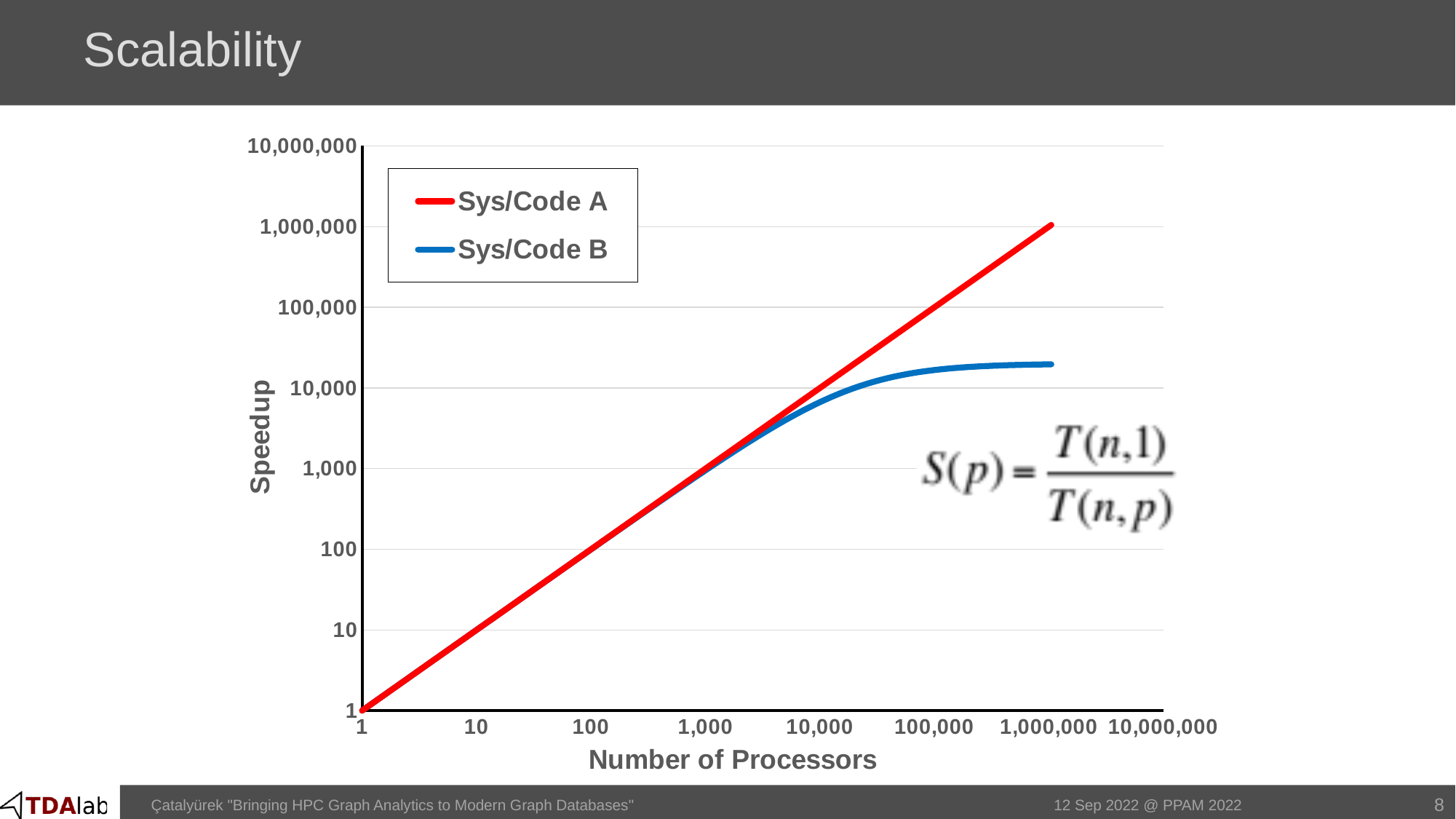
Is the speedup for Sys/Code B at 1,000,000 processors greater or less than 100,000? less Is the speedup for Sys/Code A at 1,000,000 processors greater or less than 100,000? greater Does the speedup for Sys/Code A rise or fall as the number of processors increases? rise What is the title of the x axis? Number of Processors What kind of chart is shown on the slide? Line chart Is the speedup for Sys/Code A at 100 processors greater or less than 1,000? less How many series does the legend list? 2 Which series reaches the highest speedup on the chart? Sys/Code A What is the title of the y axis? Speedup At 1,000,000 processors, which series has the higher speedup, Sys/Code A or Sys/Code B? Sys/Code A Which series flattens out at high processor counts instead of continuing to rise? Sys/Code B